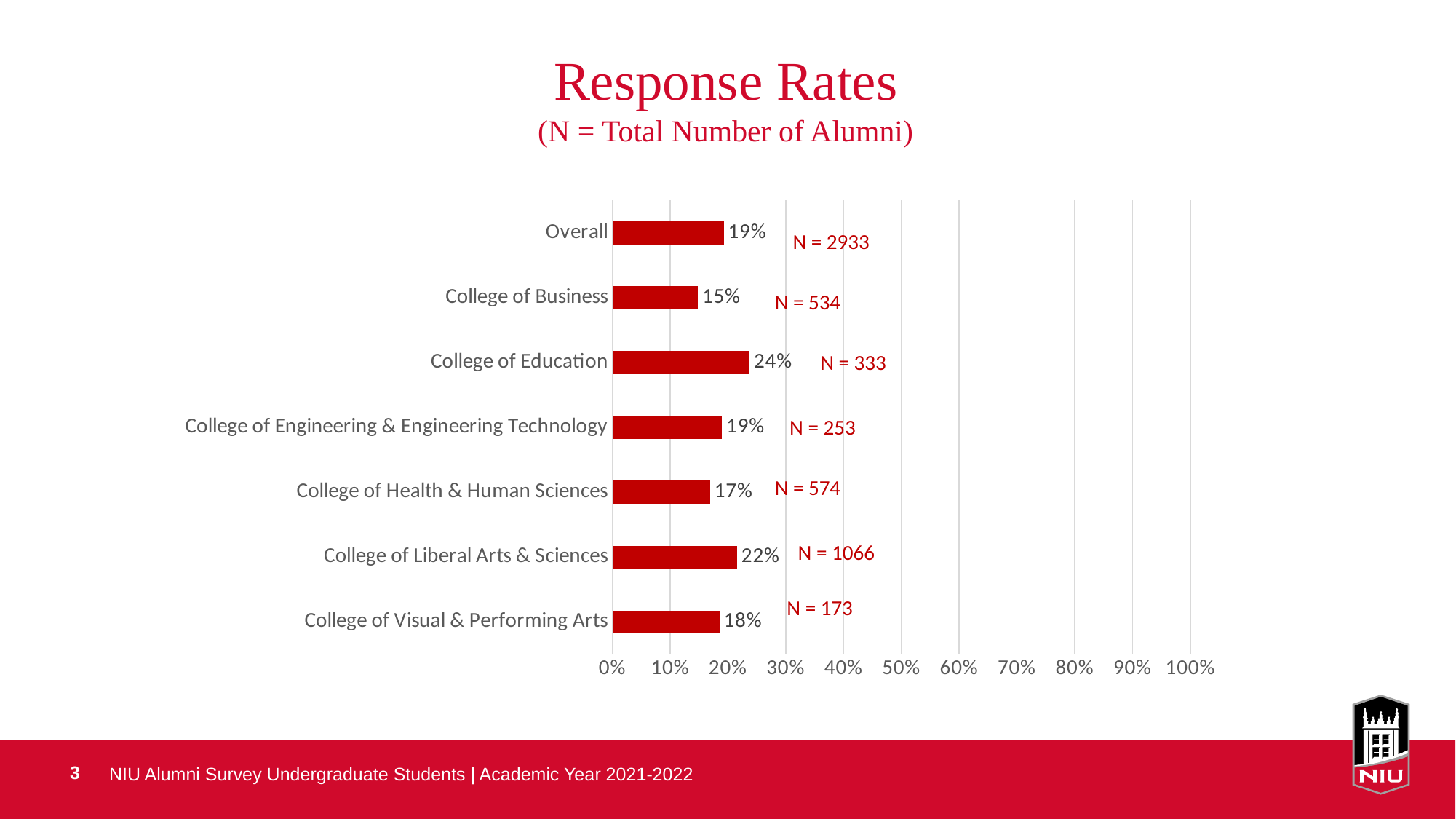
What is the total number of alumni (N) for the College of Liberal Arts & Sciences? N = 1066 What kind of chart is shown on the slide? Bar chart Which college has the lowest response rate? College of Business What is the difference between the response rates of the College of Education and the College of Business? 9% What is the response rate for the College of Education? 24% What is the response rate for the College of Business? 15% What is the title of the chart on the slide? Response Rates Which has a higher response rate, the College of Liberal Arts & Sciences or the College of Health & Human Sciences? College of Liberal Arts & Sciences Which college has the highest response rate? College of Education Is the response rate for the College of Visual & Performing Arts greater or less than 20%? less How many categories (bars) are shown in the chart? 7 What is the Overall response rate? 19%